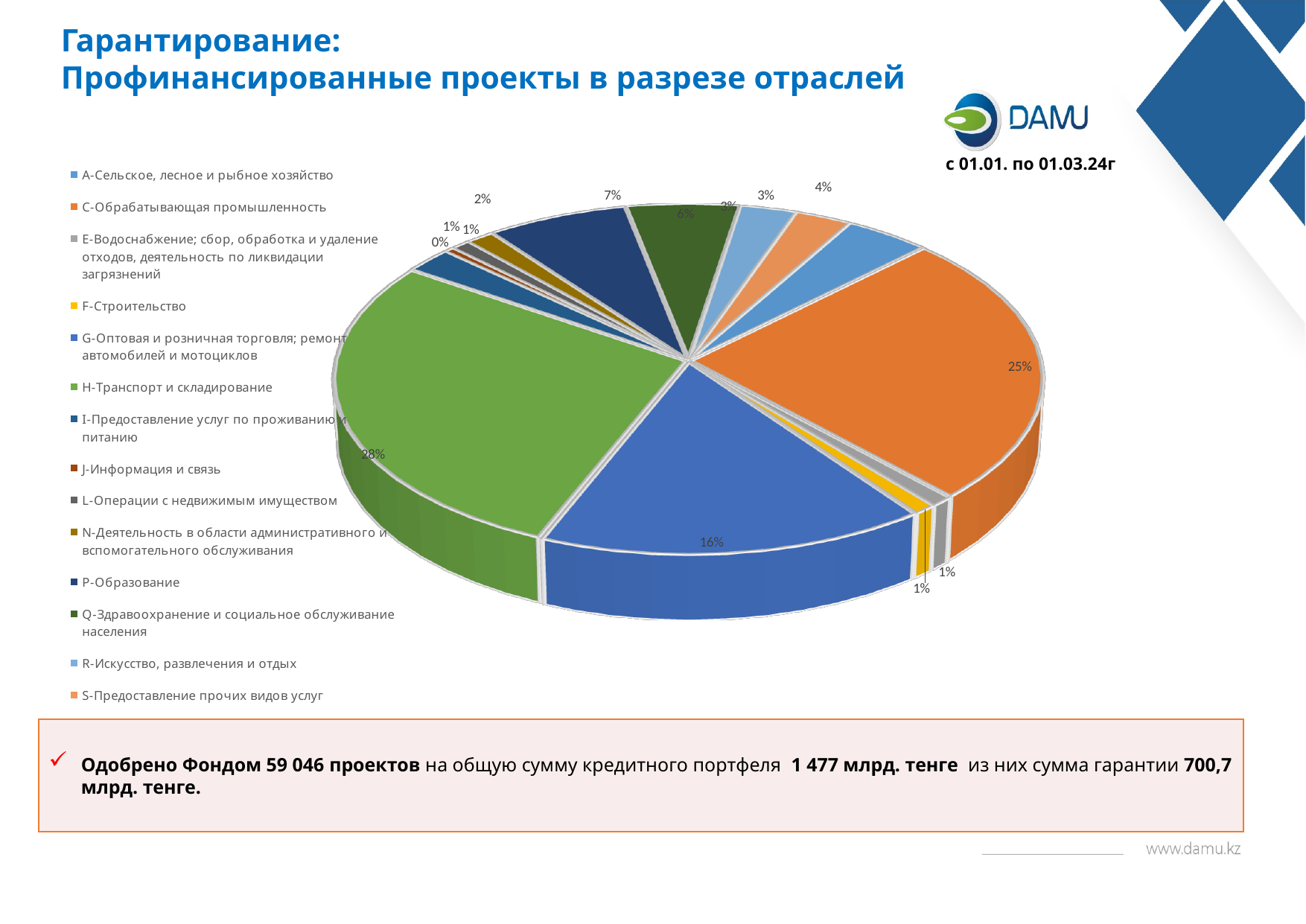
How many industry categories does the legend list? 14 What period does the chart cover, according to the label above it? с 01.01. по 01.03.24г What kind of chart is shown on the slide? pie chart What share of the pie does P-Образование have? 7% Which industry has the largest share of the pie? H-Транспорт и складирование What share of the pie does H-Транспорт и складирование have? 28% What colour is the slice for H-Транспорт и складирование? green Which is larger: the share of C-Обрабатывающая промышленность or the share of G-Оптовая и розничная торговля? C-Обрабатывающая промышленность What is the difference in percentage points between the shares of H-Транспорт и складирование and C-Обрабатывающая промышленность? 3 percentage points What share of the pie does Q-Здравоохранение и социальное обслуживание населения have? 6%